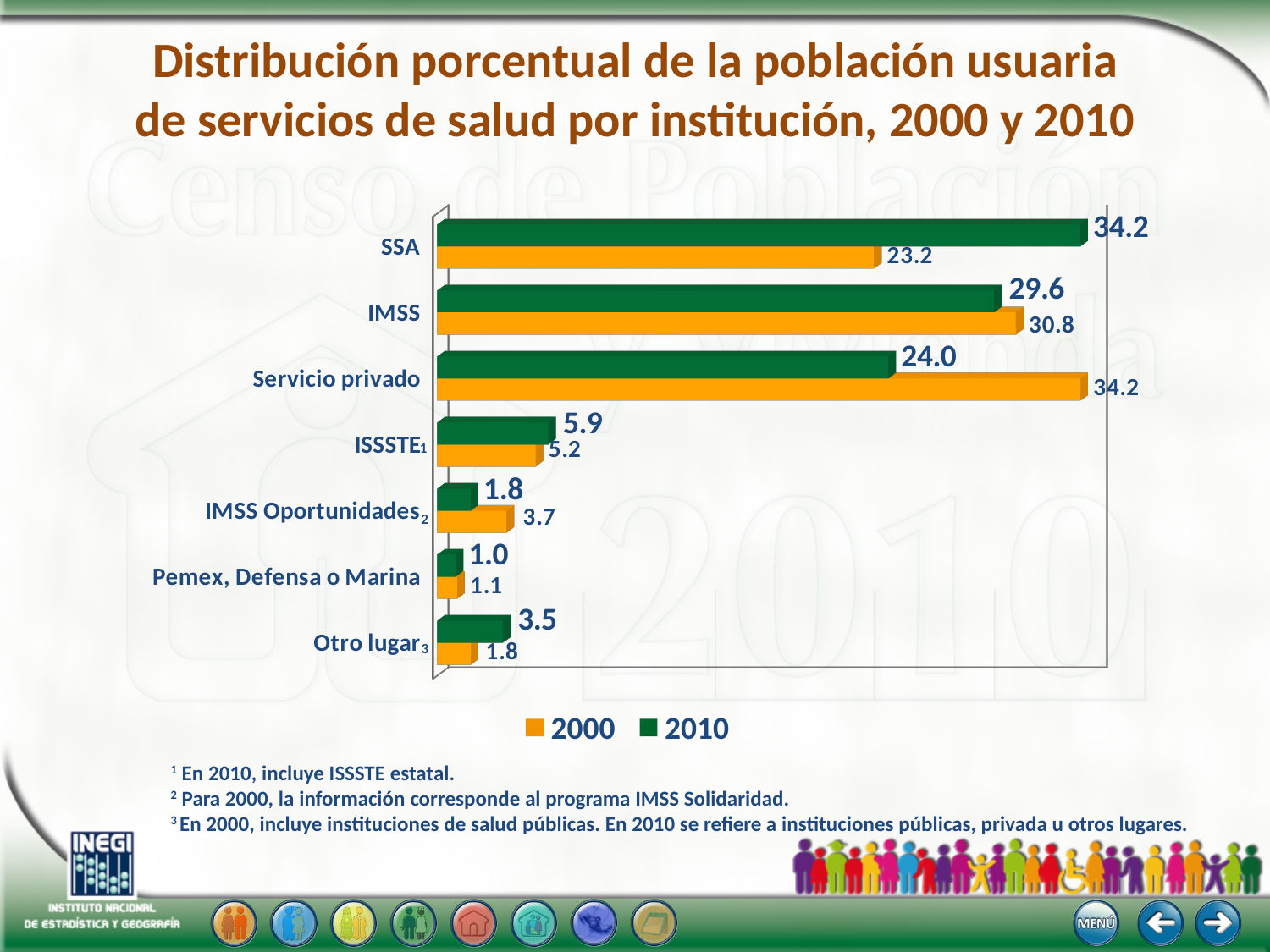
How many series does the legend list? 2 What is the value for Servicio privado in 2000? 34.2 Which category has the lowest value in the 2010 series? Pemex, Defensa o Marina What is the difference between the 2010 and 2000 values for SSA? 11.0 What is the value for IMSS Oportunidades in 2000? 3.7 What is the difference between the 2000 and 2010 values for Servicio privado? 10.2 For IMSS, which year has the larger value, 2000 or 2010? 2000 How many categories are shown on the chart? 7 What is the value for SSA in 2010? 34.2 What kind of chart is shown on the slide? Bar chart Which category has the highest value in the 2000 series? Servicio privado Which category has the highest value in the 2010 series? SSA